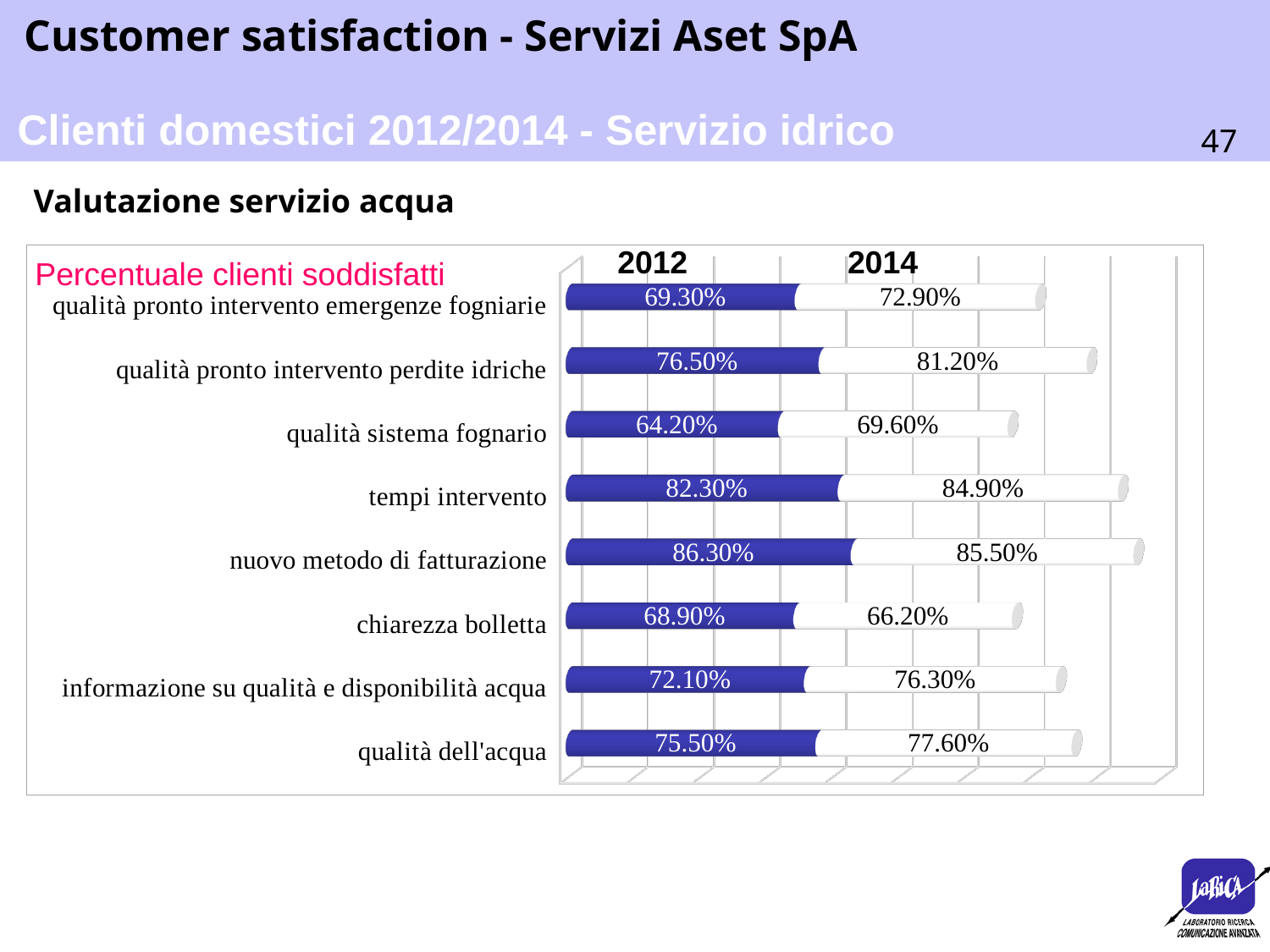
What is the 2014 value for 'chiarezza bolletta'? 66.20% How many series does the chart show? 2 What is the difference between the 2014 and 2012 values for 'tempi intervento'? 2.60 percentage points Which category has the lowest 2014 value? chiarezza bolletta How many categories are shown in the chart? 8 Which category has the highest 2012 value? nuovo metodo di fatturazione What kind of chart is shown on the slide? bar chart What is the 2014 value for 'qualità pronto intervento perdite idriche'? 81.20% Which category has the lowest 2012 value? qualità sistema fognario What is the difference between the 2014 and 2012 values for 'qualità pronto intervento perdite idriche'? 4.70 percentage points What is the 2012 value for 'qualità dell'acqua'? 75.50% For 'nuovo metodo di fatturazione', which year has the larger value, 2012 or 2014? 2012